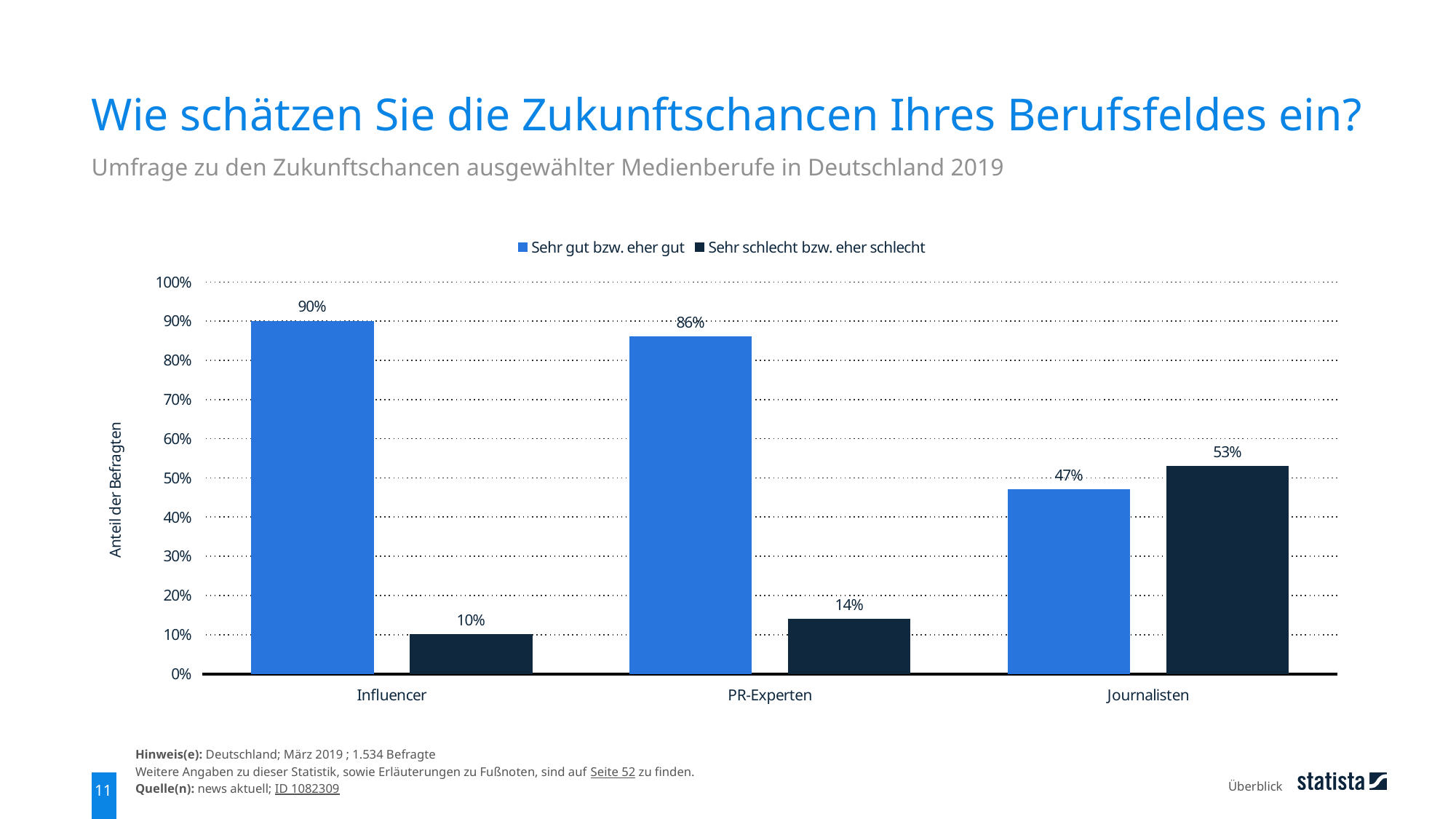
What is the label of the y axis? Anteil der Befragten Which category has the lowest 'Sehr schlecht bzw. eher schlecht' value? Influencer What is the difference between the 'Sehr gut bzw. eher gut' values for Influencer and Journalisten? 43 percentage points What share of Journalisten respondents rated the future prospects as 'Sehr schlecht bzw. eher schlecht'? 53% What kind of chart is shown on the slide? Bar chart Is the 'Sehr schlecht bzw. eher schlecht' value for PR-Experten greater or less than 20%? less Which category has the highest 'Sehr gut bzw. eher gut' value? Influencer How many series does the legend list? 2 What is the 'Sehr gut bzw. eher gut' value for PR-Experten? 86% How many categories are shown on the x axis? 3 What share of Influencer respondents rated the future prospects as 'Sehr gut bzw. eher gut'? 90% For Journalisten, which is larger: 'Sehr gut bzw. eher gut' or 'Sehr schlecht bzw. eher schlecht'? Sehr schlecht bzw. eher schlecht